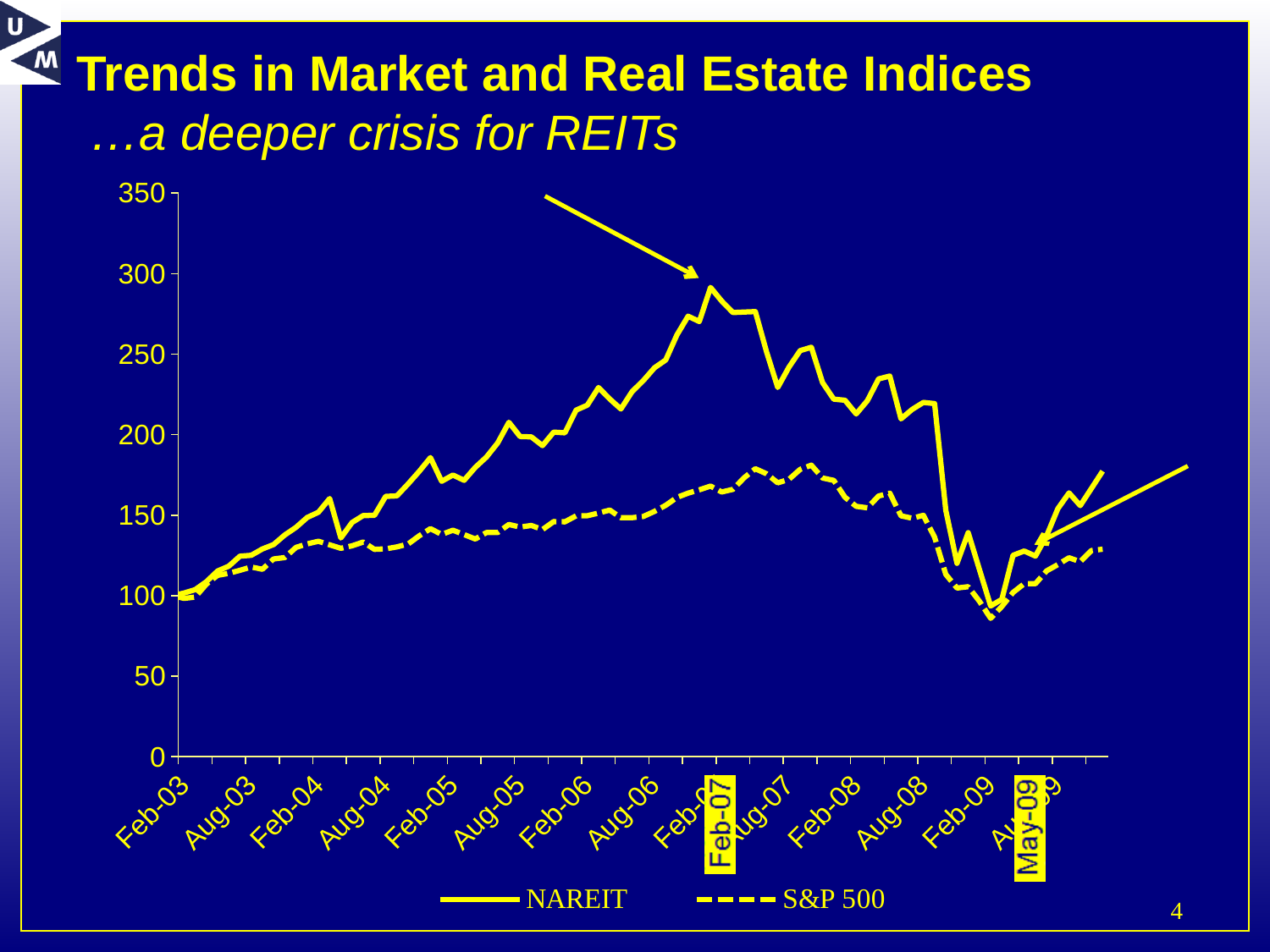
Does the NAREIT series rise or fall between Feb-07 and Feb-09? fall Is the value of NAREIT at Feb-07 greater or less than 250? greater Does the NAREIT series rise or fall between Feb-03 and Feb-07? rise Which series is drawn with a dashed line? S&P 500 Is the value of NAREIT at Feb-04 greater or less than 100? greater Is the value of S&P 500 at Feb-07 greater or less than 200? less Which series reaches the highest value on the chart? NAREIT Which two series are listed in the chart legend? NAREIT and S&P 500 How many series does the legend list? 2 At Feb-07, which series has the higher value, NAREIT or S&P 500? NAREIT What kind of chart is shown on the slide? line chart